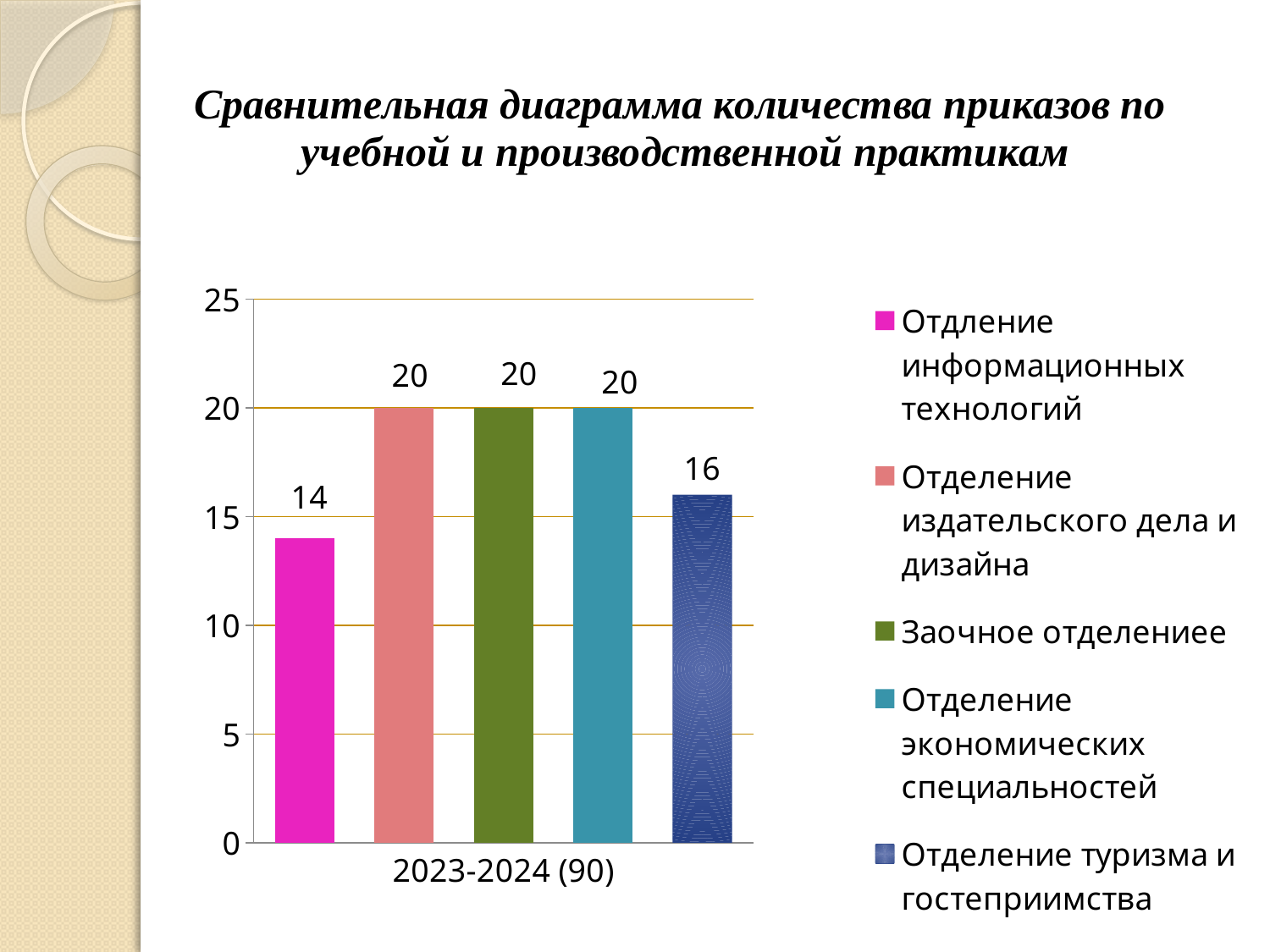
How many series does the legend list? 5 What is the difference between the value for Отделение экономических специальностей and the value for Отделение туризма и гостеприимства? 4 What is the value for Заочное отделениее? 20 What kind of chart is shown on the slide? bar chart What is the value for Отдление информационных технологий? 14 Is the value for Отдление информационных технологий greater or less than 15? less How many categories are shown on the x axis? 1 Which series has the lowest value? Отдление информационных технологий What is the label of the category on the x axis? 2023-2024 (90) What is the difference between the value for Отделение издательского дела и дизайна and the value for Отдление информационных технологий? 6 What is the value for Отделение туризма и гостеприимства? 16 Which is larger, the value for Отделение туризма и гостеприимства or the value for Отдление информационных технологий? Отделение туризма и гостеприимства